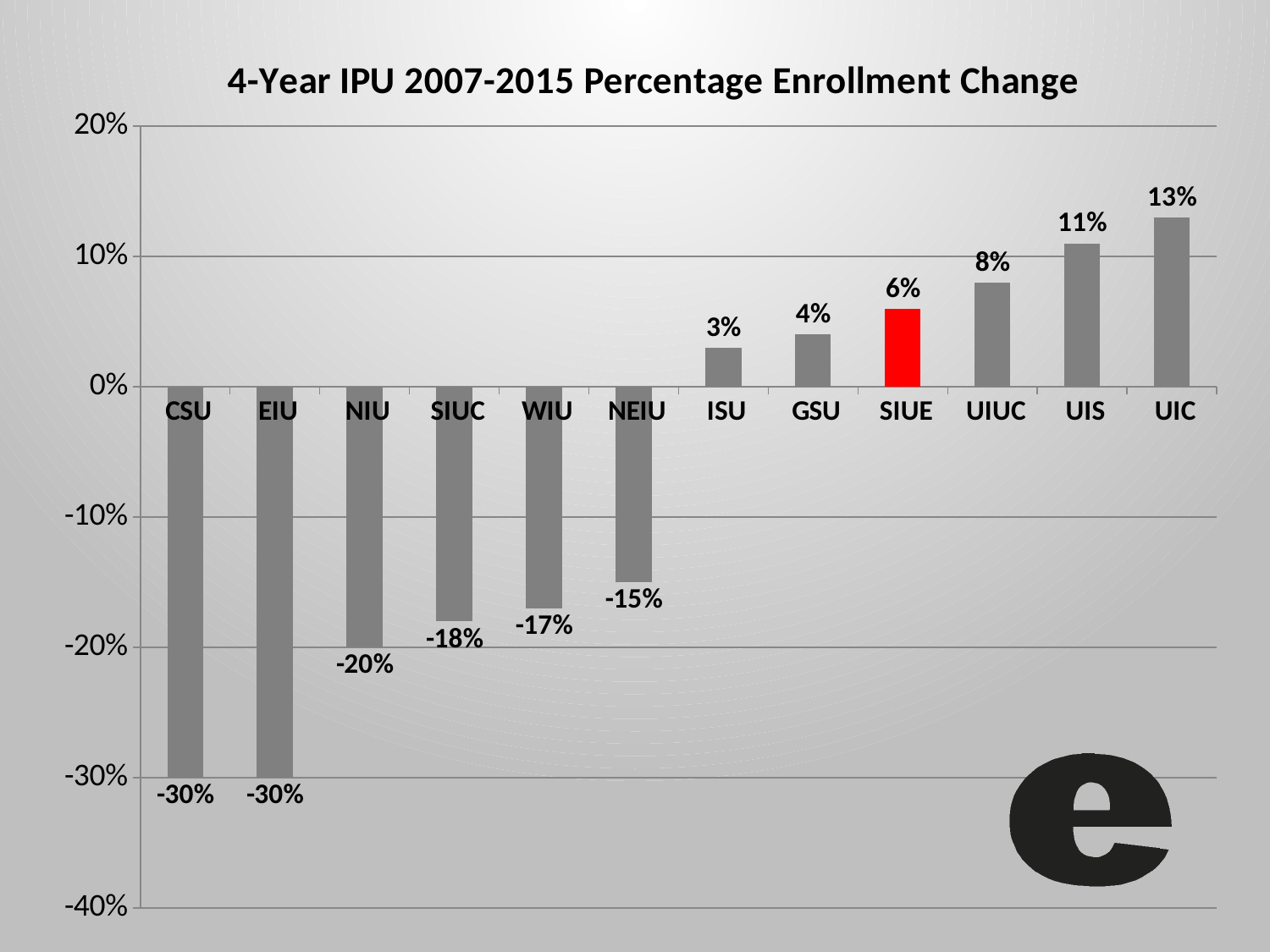
Which has a larger percentage enrollment change, GSU or UIUC? UIUC What is the difference between the enrollment change for UIS and the enrollment change for ISU? 8% Which institution has the highest percentage enrollment change? UIC What kind of chart is shown on the slide? bar chart What is the percentage enrollment change for UIC? 13% What is the percentage enrollment change for SIUE? 6% Is the value for WIU greater or less than -10%? less What is the percentage enrollment change for NIU? -20% What is the title of the chart? 4-Year IPU 2007-2015 Percentage Enrollment Change Which institution's bar is coloured red? SIUE Do the values rise or fall from left to right across the x axis? rise How many institutions are shown on the chart? 12